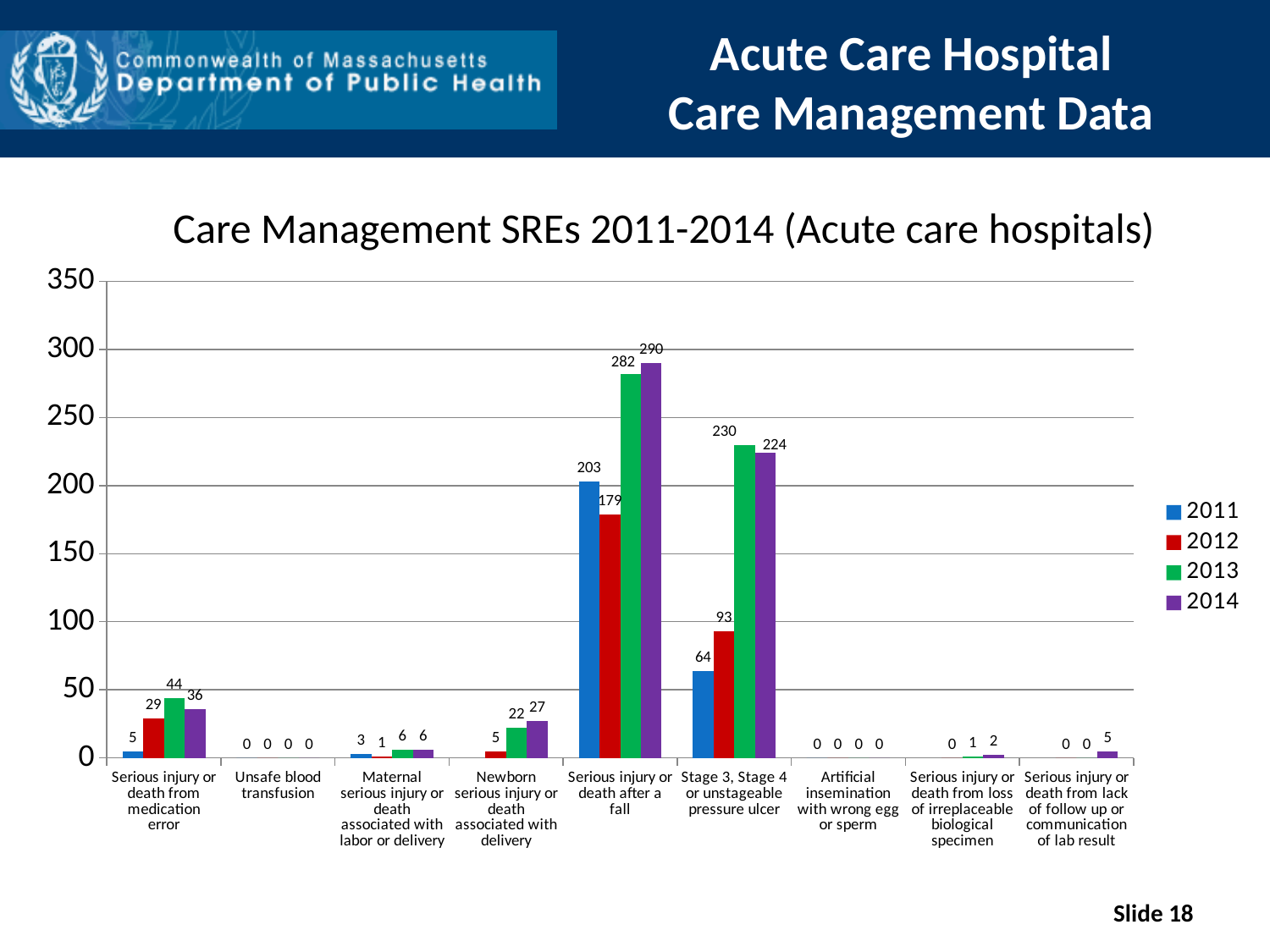
What is the 2011 value for Stage 3, Stage 4 or unstageable pressure ulcer? 64 What is the 2014 value for Serious injury or death after a fall? 290 Is the 2011 value for Serious injury or death after a fall greater or less than 200? greater Which is larger for Stage 3, Stage 4 or unstageable pressure ulcer: the 2013 value or the 2014 value? 2013 Do the values for Newborn serious injury or death associated with delivery rise or fall from 2011 to 2014? rise What kind of chart is shown? bar chart Which category has the highest 2013 value? Serious injury or death after a fall How many categories are shown on the x axis? 9 What is the difference between the 2013 and 2012 values for Serious injury or death after a fall? 103 How many series does the legend list? 4 What is the 2013 value for Serious injury or death from medication error? 44 What is the title of the chart? Care Management SREs 2011-2014 (Acute care hospitals)